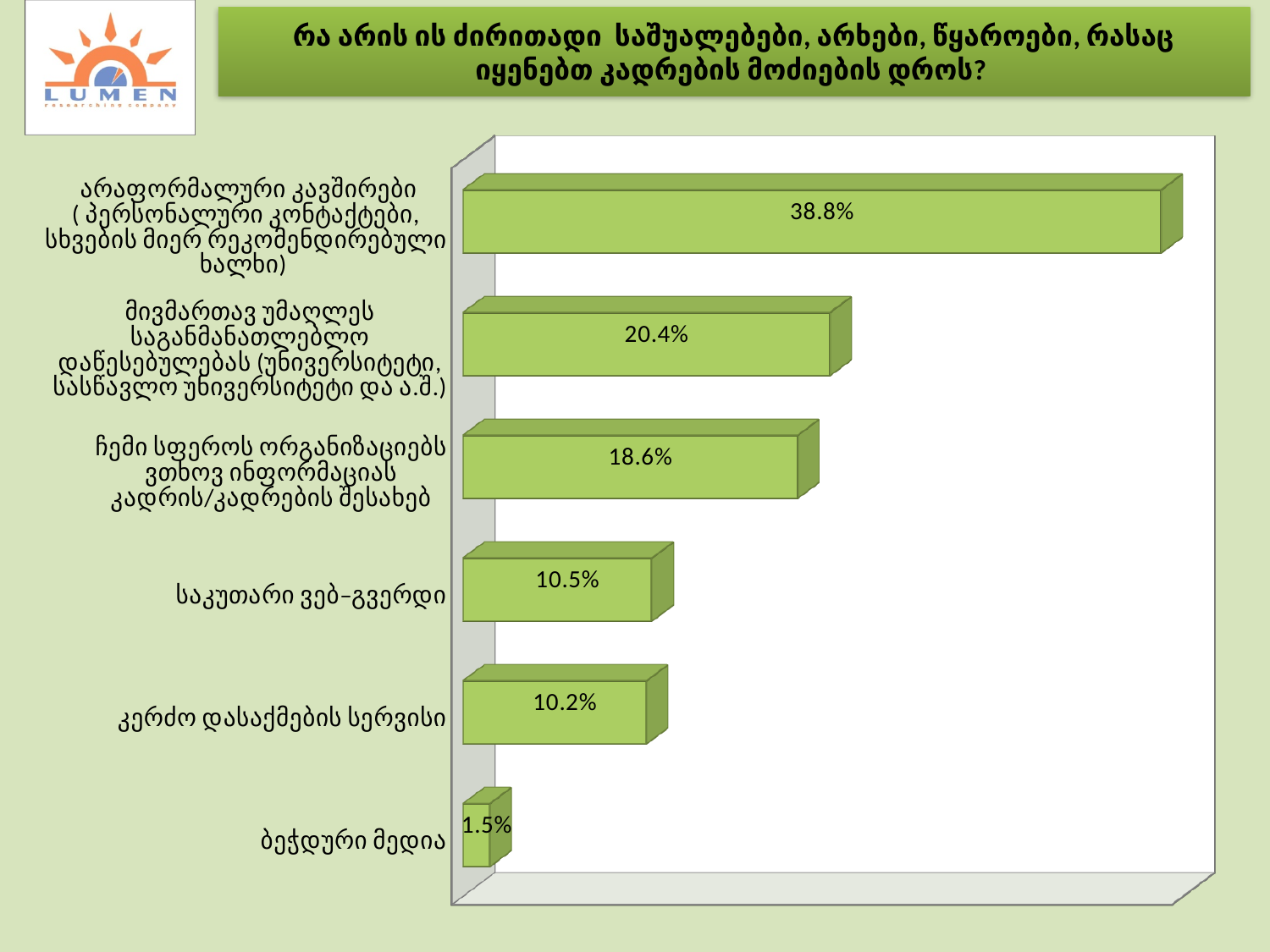
What is the difference between the value for ჩემი სფეროს ორგანიზაციებს ვთხოვ ინფორმაციას and the value for ბეჭდური მედია? 17.1% What is the value for საკუთარი ვებ-გვერდი? 10.5% What is the difference between the value for არაფორმალური კავშირები and the value for მივმართავ უმაღლეს საგანმანათლებლო დაწესებულებას? 18.4% What kind of chart is shown on the slide? Bar chart What is the value for ბეჭდური მედია? 1.5% Which category has the lowest value? ბეჭდური მედია What colour are the bars in the chart? Green How many categories are shown in the chart? 6 Which is larger: the value for საკუთარი ვებ-გვერდი or the value for კერძო დასაქმების სერვისი? საკუთარი ვებ-გვერდი Which category has the highest value? არაფორმალური კავშირები (პერსონალური კონტაქტები, სხვების მიერ რეკომენდირებული ხალხი) What is the value for კერძო დასაქმების სერვისი? 10.2% What is the value for the category ჩემი სფეროს ორგანიზაციებს ვთხოვ ინფორმაციას კადრის/კადრების შესახებ? 18.6%